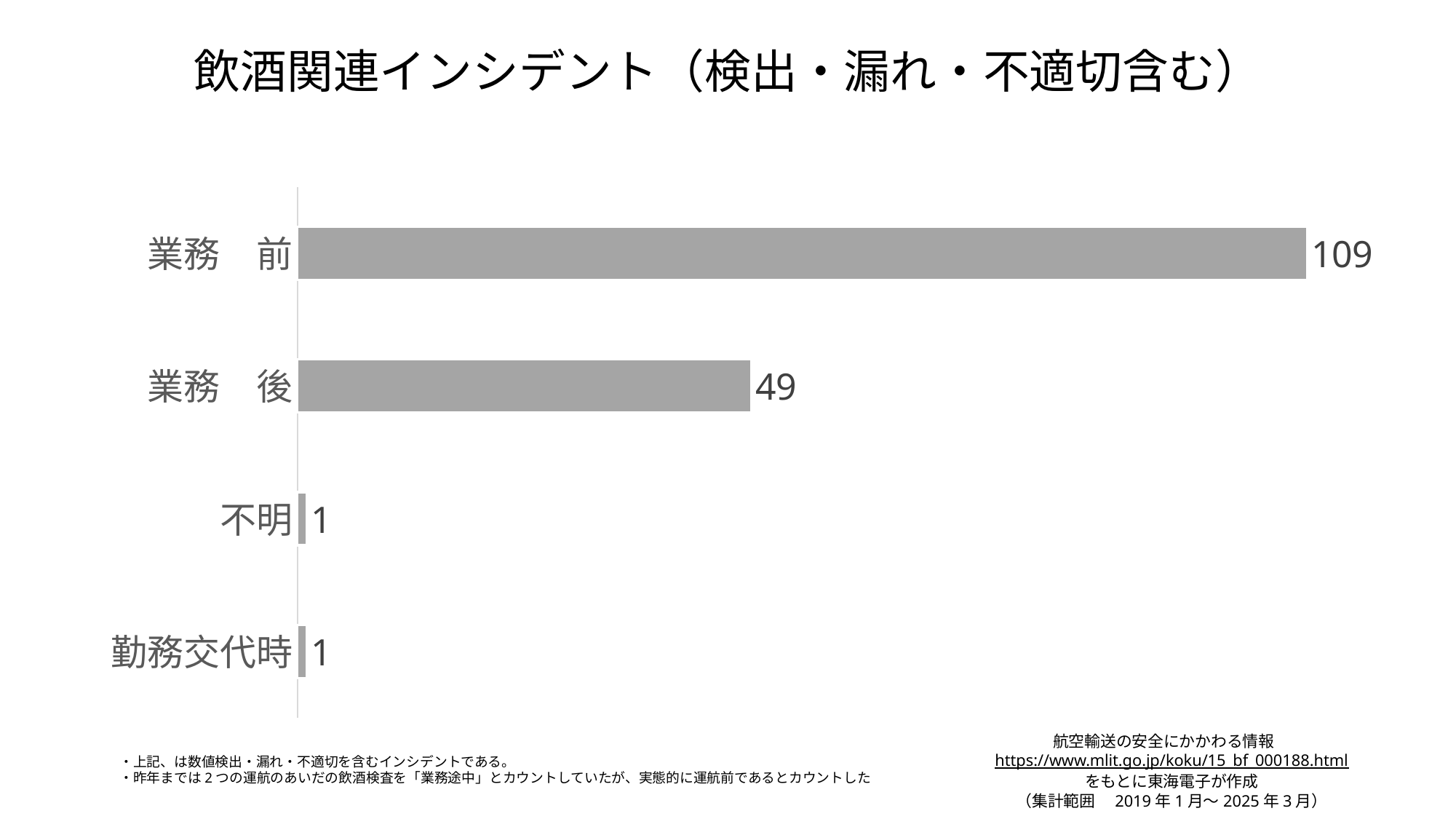
Which is larger, the value for 業務 後 or the value for 不明? 業務 後 What kind of chart is shown on the slide? Bar chart What colour are the bars in the chart? Grey Which category has the highest value? 業務 前 What is the value for 勤務交代時? 1 What is the value for 業務 後? 49 What is the difference between the values for 業務 前 and 業務 後? 60 What is the total of all four values shown in the chart? 160 How many categories are shown in the chart? 4 What is the title of the chart on the slide? 飲酒関連インシデント（検出・漏れ・不適切含む） What is the value for 不明? 1 What is the value for 業務 前? 109